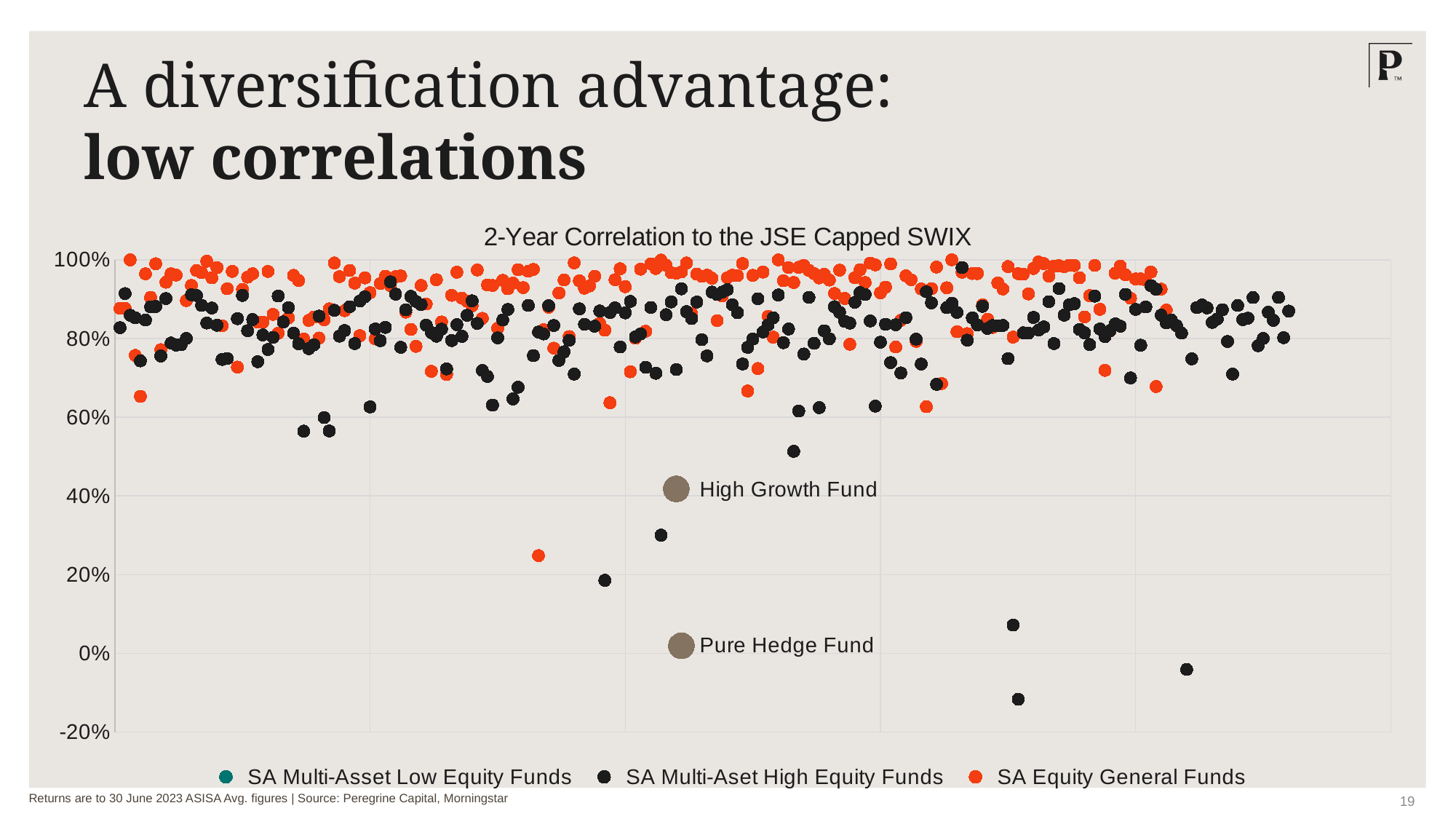
Which of the two labelled funds has the higher correlation, High Growth Fund or Pure Hedge Fund? High Growth Fund Is the value for High Growth Fund greater or less than 60%? less What kind of chart is shown on the slide? scatter chart What is the title of the chart? 2-Year Correlation to the JSE Capped SWIX What is the lowest value shown on the vertical axis? -20% How many individual funds are labelled by name on the chart? 2 Is the value for High Growth Fund greater or less than 20%? greater Is the value for Pure Hedge Fund greater or less than 20%? less How many series does the chart legend list? 3 Which of the two labelled funds has the lower correlation? Pure Hedge Fund Which series is shown in orange in the legend? SA Equity General Funds